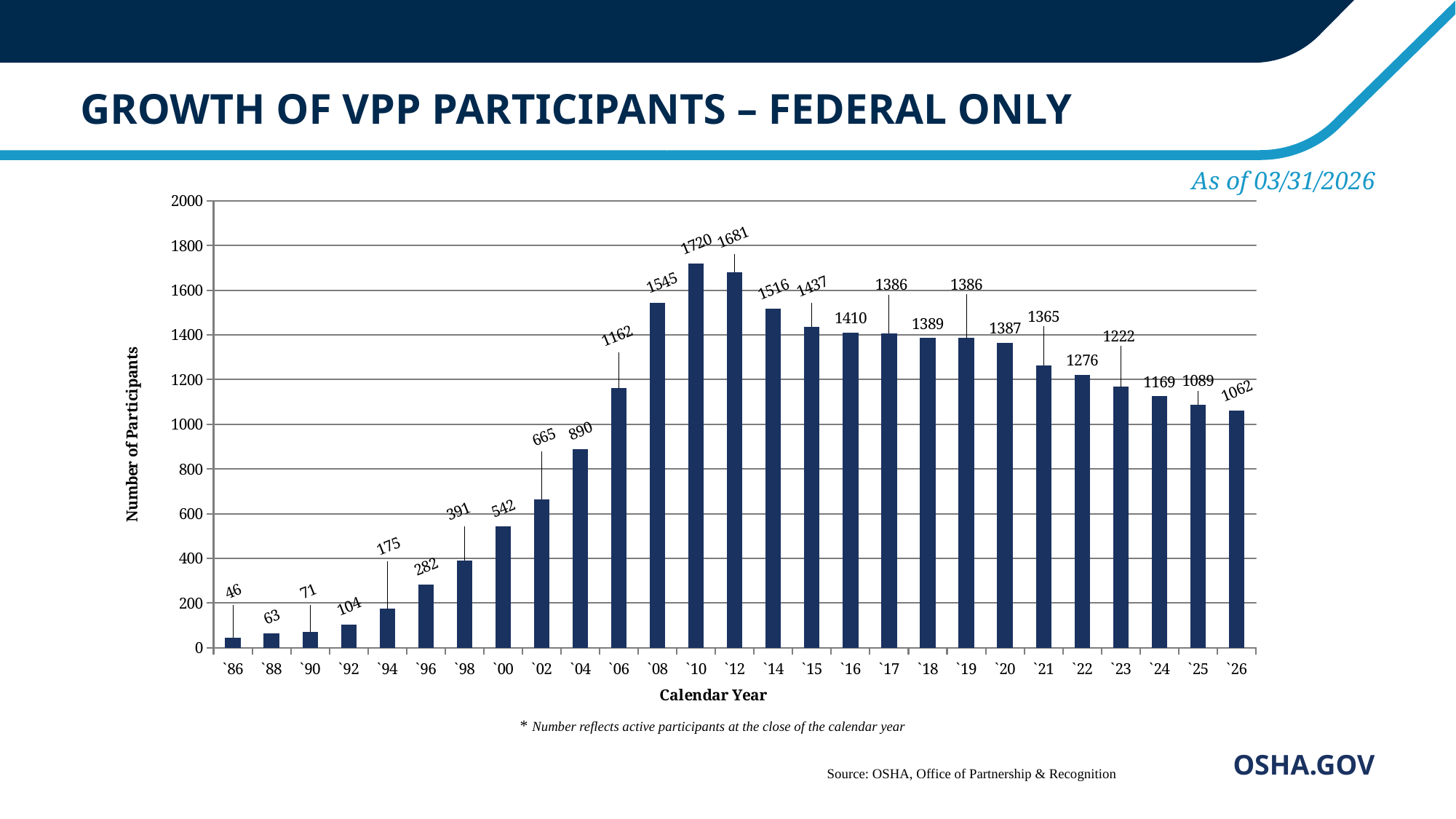
How many calendar years are shown on the x axis? 27 What is the number of participants for `10? 1720 What is the difference in participants between `08 and `06? 383 What is the number of participants for `26? 1062 What kind of chart is shown on the slide? bar chart What is the number of participants for `94? 175 Do the values rise or fall from `10 to `26? fall Is the value for `02 greater or less than 800? less Which calendar year has the lowest number of participants? `86 Which year has more participants, `14 or `15? `14 What is the difference in participants between `10 and `12? 39 Which calendar year has the highest number of participants? `10